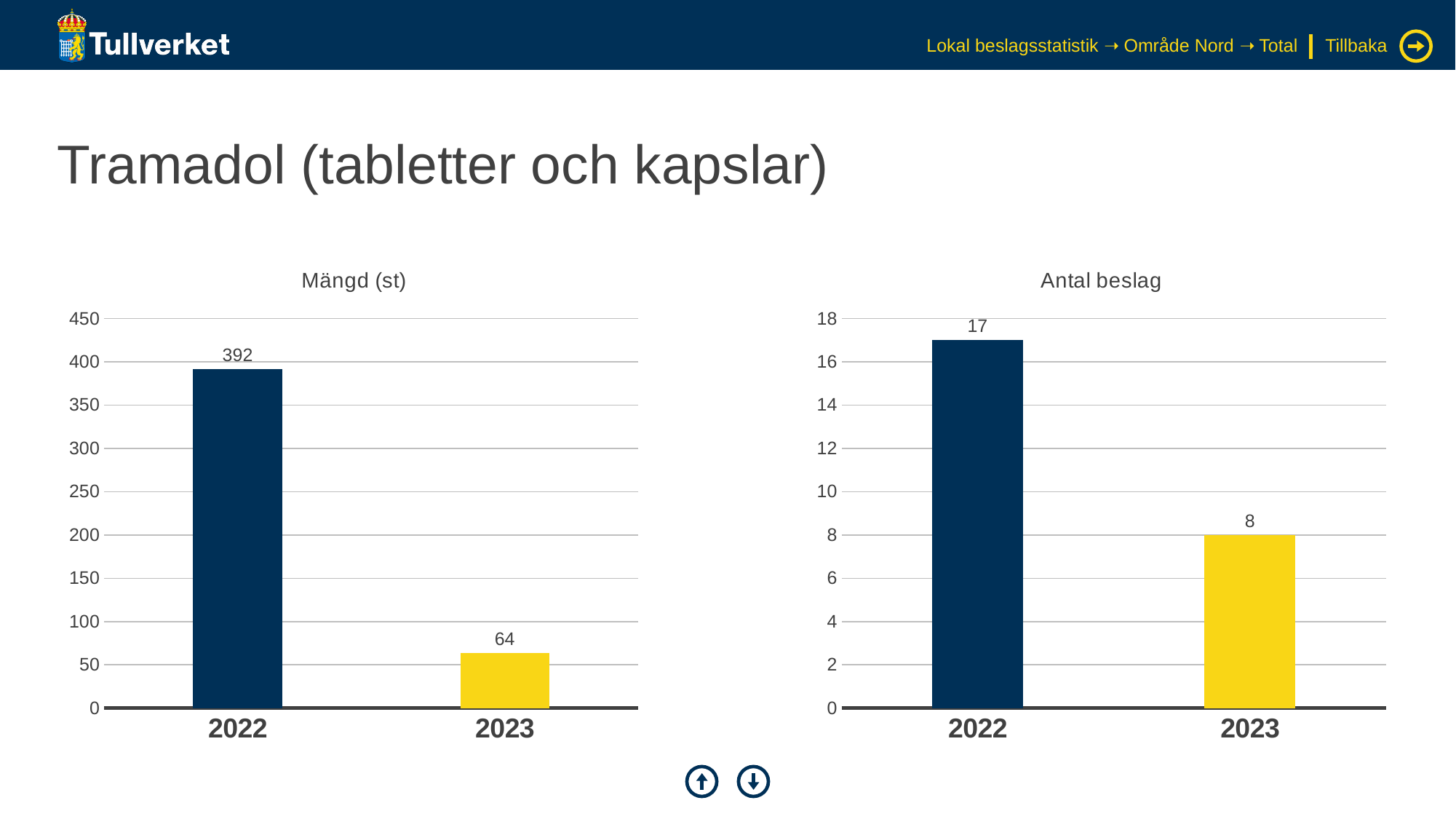
In the "Mängd (st)" chart, what is the value for 2022? 392 In the "Antal beslag" chart, which year has the lowest value? 2023 In the "Antal beslag" chart, what is the difference between the 2022 and 2023 values? 9 In the "Antal beslag" chart, what is the value for 2023? 8 In the "Antal beslag" chart, what is the value for 2022? 17 In the "Mängd (st)" chart, which year has the highest value? 2022 What kind of chart is the "Antal beslag" chart? bar chart In the "Mängd (st)" chart, what is the value for 2023? 64 In the "Mängd (st)" chart, what is the difference between the 2022 and 2023 values? 328 In the "Mängd (st)" chart, do the values rise or fall from 2022 to 2023? fall How many categories are shown on the x axis of the "Mängd (st)" chart? 2 In the "Antal beslag" chart, is the value for 2022 larger or smaller than the value for 2023? larger